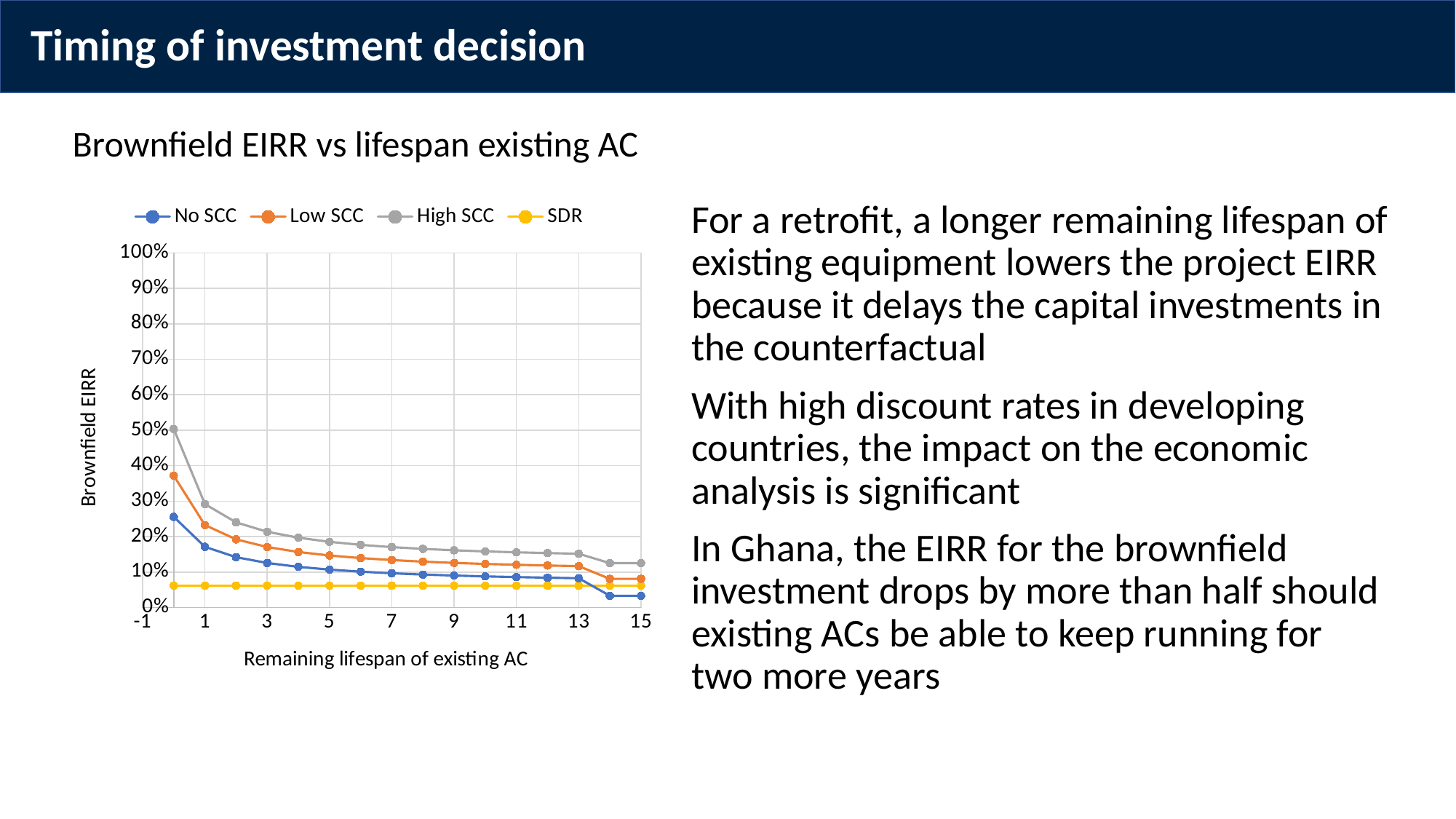
What kind of chart is shown on the slide? line chart How many series does the legend list? 4 What is the title of the chart's vertical axis? Brownfield EIRR Is the High SCC value at a remaining lifespan of 0 greater or less than 40%? greater Which series has the highest Brownfield EIRR at a remaining lifespan of 0? High SCC Is the SDR value at a remaining lifespan of 5 greater or less than 10%? less Which is larger at a remaining lifespan of 1: the High SCC value or the Low SCC value? High SCC Do the High SCC values rise or fall as the remaining lifespan of existing AC increases? fall Is the Low SCC value at a remaining lifespan of 0 greater or less than 30%? greater